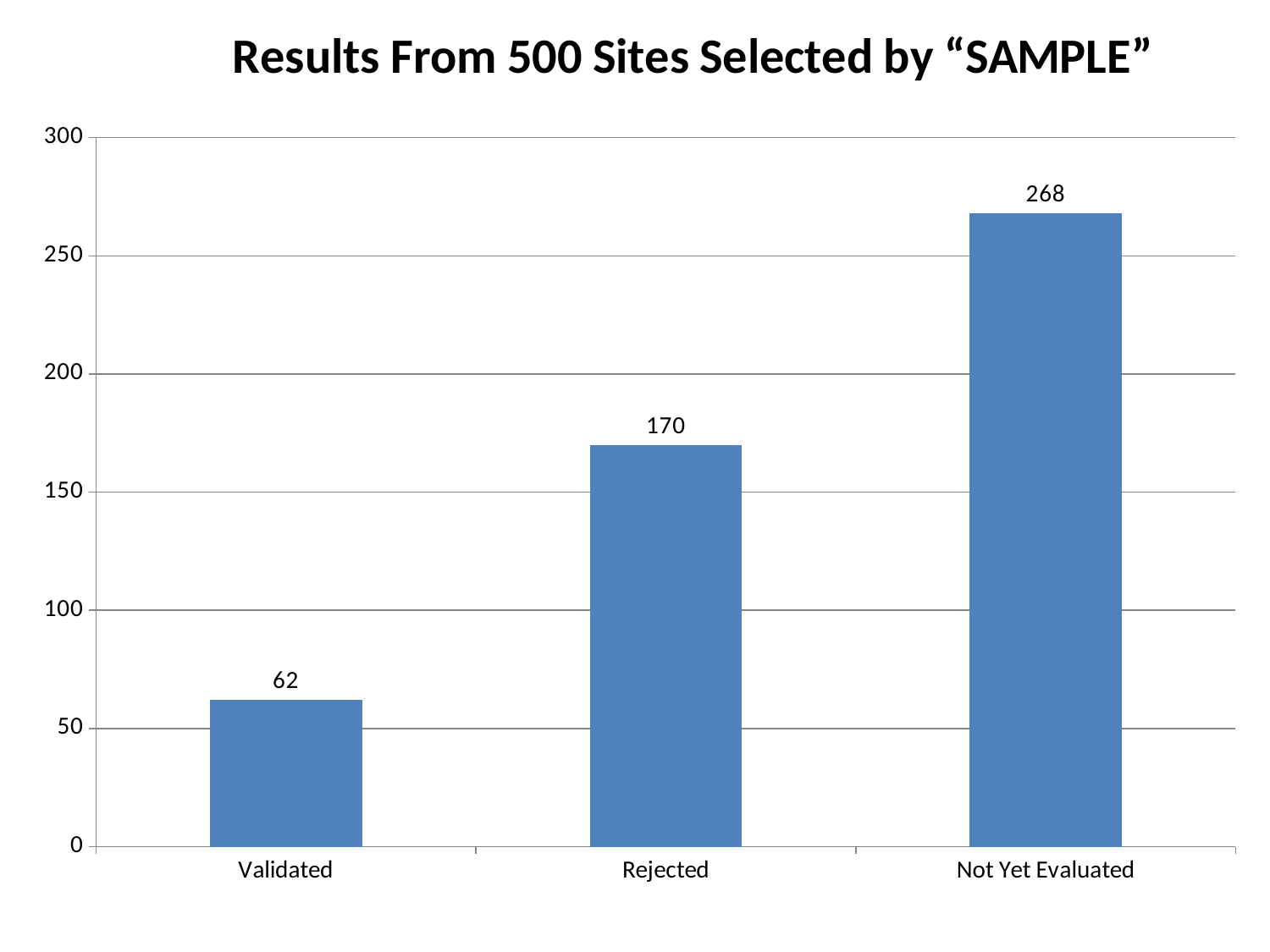
What is the difference between the values for Rejected and Validated? 108 Which category has the highest value? Not Yet Evaluated What is the value for Not Yet Evaluated? 268 What is the value for Rejected? 170 How many categories are shown on the x axis? 3 Which is larger, the value for Rejected or the value for Validated? Rejected Is the value for Rejected greater or less than 150? greater What is the difference between the values for Not Yet Evaluated and Rejected? 98 Which category has the lowest value? Validated What is the value for Validated? 62 What is the title of the chart? Results From 500 Sites Selected by "SAMPLE" What kind of chart is shown on the slide? bar chart